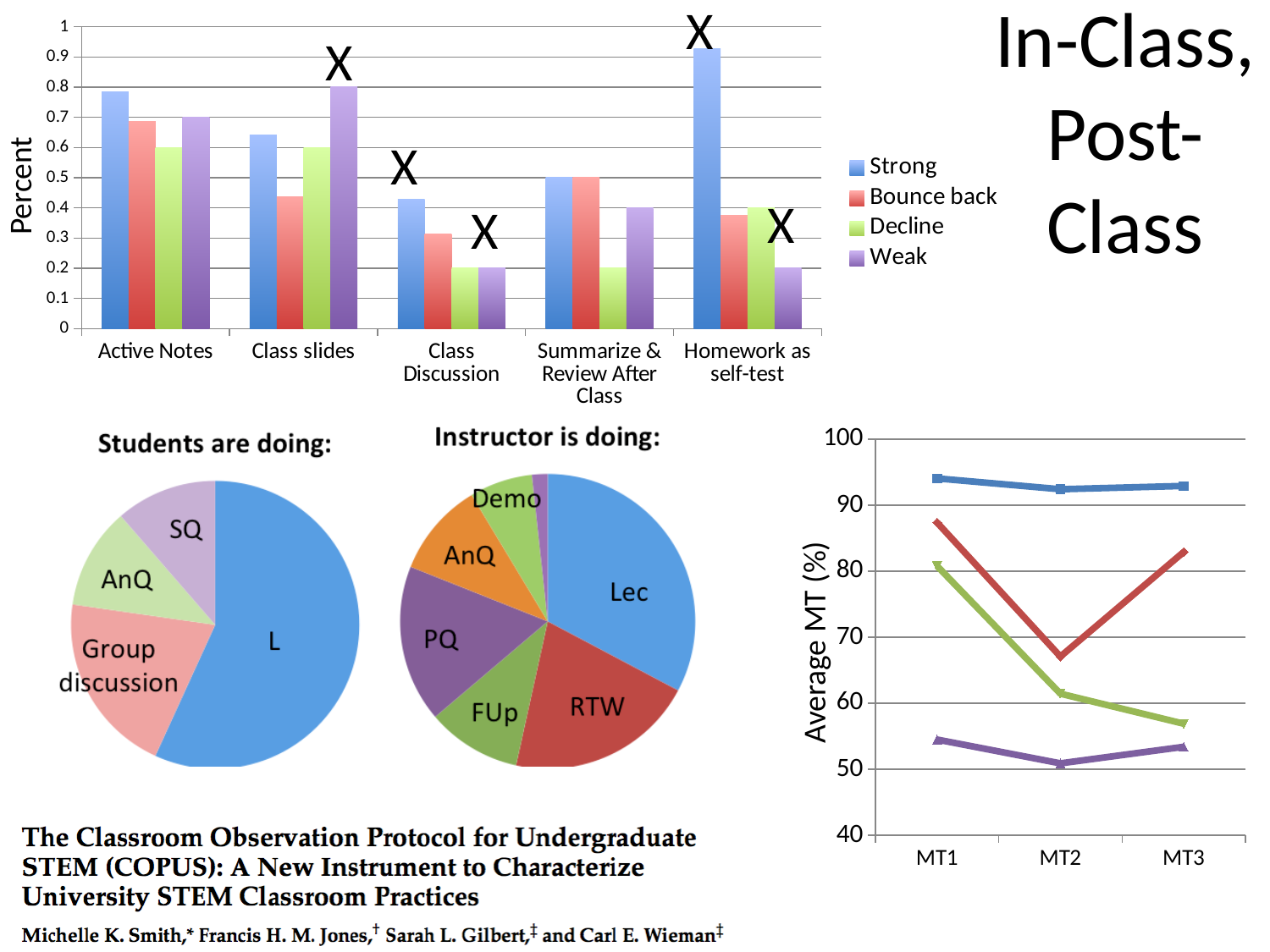
In the 'Students are doing:' pie chart, which slice is the largest? L In the top bar chart, how many series does the legend list? 4 In the bottom-right line chart (Average MT (%)), does the green line rise or fall from MT1 to MT3? fall In the top bar chart, which series has the lowest value for Homework as self-test? Weak In the top bar chart, which is larger: the Strong value for Active Notes or the Strong value for Class slides? Active Notes In the top bar chart, is the Weak value for Class Discussion greater or less than 0.3? less In the top bar chart, which series has the highest value for Class slides? Weak In the top bar chart, which category has the highest Strong value? Homework as self-test In the top bar chart, is the Strong value for Homework as self-test greater or less than 0.8? greater In the top bar chart, how many categories are shown on the x axis? 5 In the bottom-right line chart (Average MT (%)), is the value of the red line at MT2 greater or less than 70? less What kind of chart is the top chart with the Percent axis? bar chart